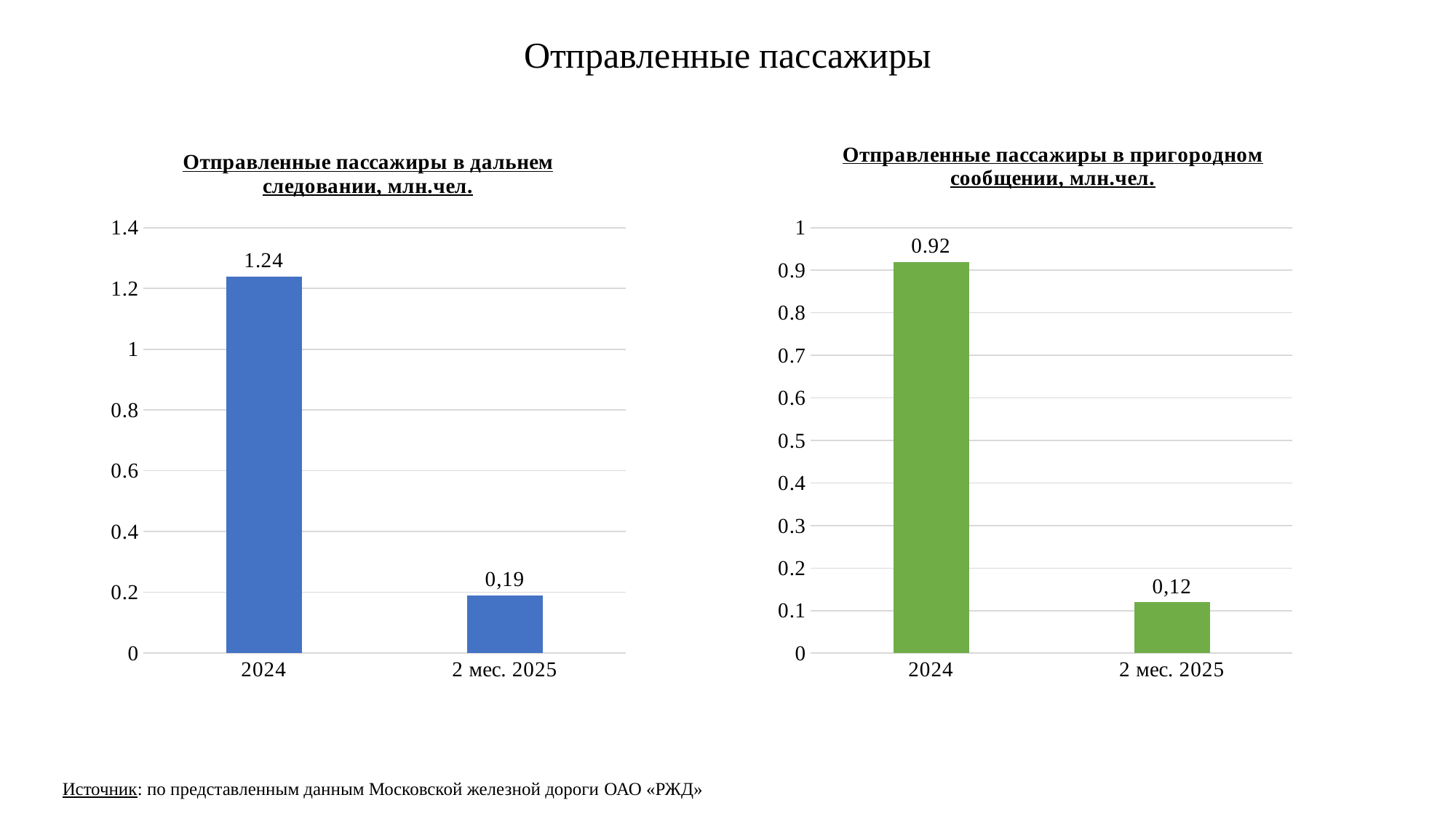
How many categories are shown in the right chart? 2 What type of chart is the left chart? bar chart In the right chart, which category has the lowest value? 2 мес. 2025 In the left chart (Отправленные пассажиры в дальнем следовании), what is the value for 2 мес. 2025? 0,19 In the left chart (Отправленные пассажиры в дальнем следовании), what is the value for 2024? 1.24 In the left chart, is the value for 2 мес. 2025 greater or less than 0.2? less In the left chart, which category has the highest value? 2024 In the right chart (Отправленные пассажиры в пригородном сообщении), what is the value for 2024? 0.92 What colour are the bars in the right chart? green In the left chart, what is the difference between the 2024 value and the 2 мес. 2025 value? 1.05 In the right chart, is the value for 2024 greater or less than 0.5? greater In the right chart (Отправленные пассажиры в пригородном сообщении), what is the value for 2 мес. 2025? 0,12